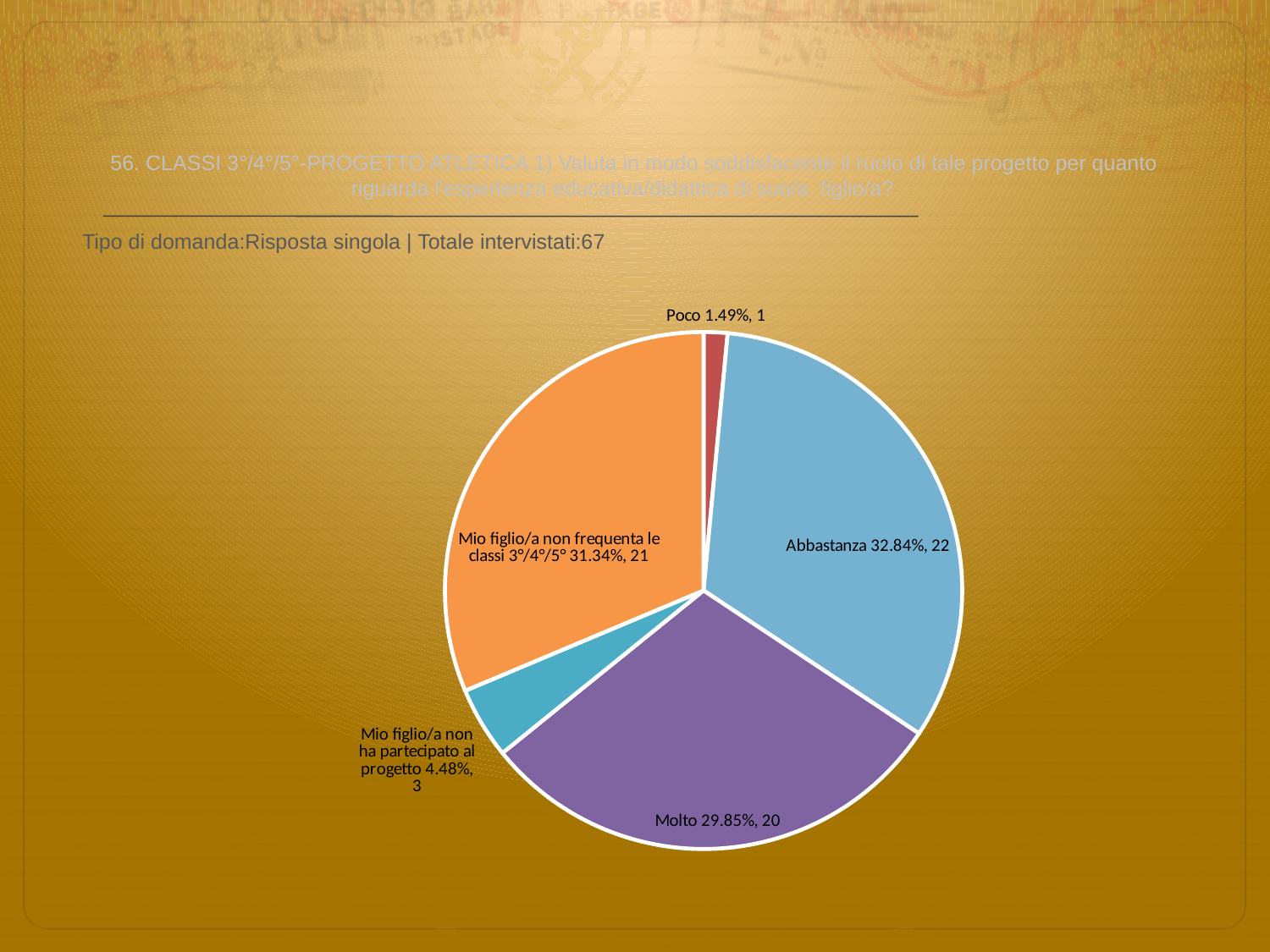
What percentage is shown for "Poco"? 1.49% How many respondents answered "Molto"? 20 What share of the pie is "Mio figlio/a non frequenta le classi 3°/4°/5°"? 31.34% What is the difference in respondent count between "Abbastanza" and "Molto"? 2 Which category has the largest slice of the pie? Abbastanza What kind of chart is shown on the slide? pie chart How many respondents chose "Mio figlio/a non ha partecipato al progetto"? 3 What is the total number of respondents (Totale intervistati) stated on the slide? 67 What percentage of respondents answered "Abbastanza"? 32.84% How many slices does the pie chart have? 5 Which category has the smallest slice of the pie? Poco Which has more respondents, "Molto" or "Mio figlio/a non frequenta le classi 3°/4°/5°"? Mio figlio/a non frequenta le classi 3°/4°/5°